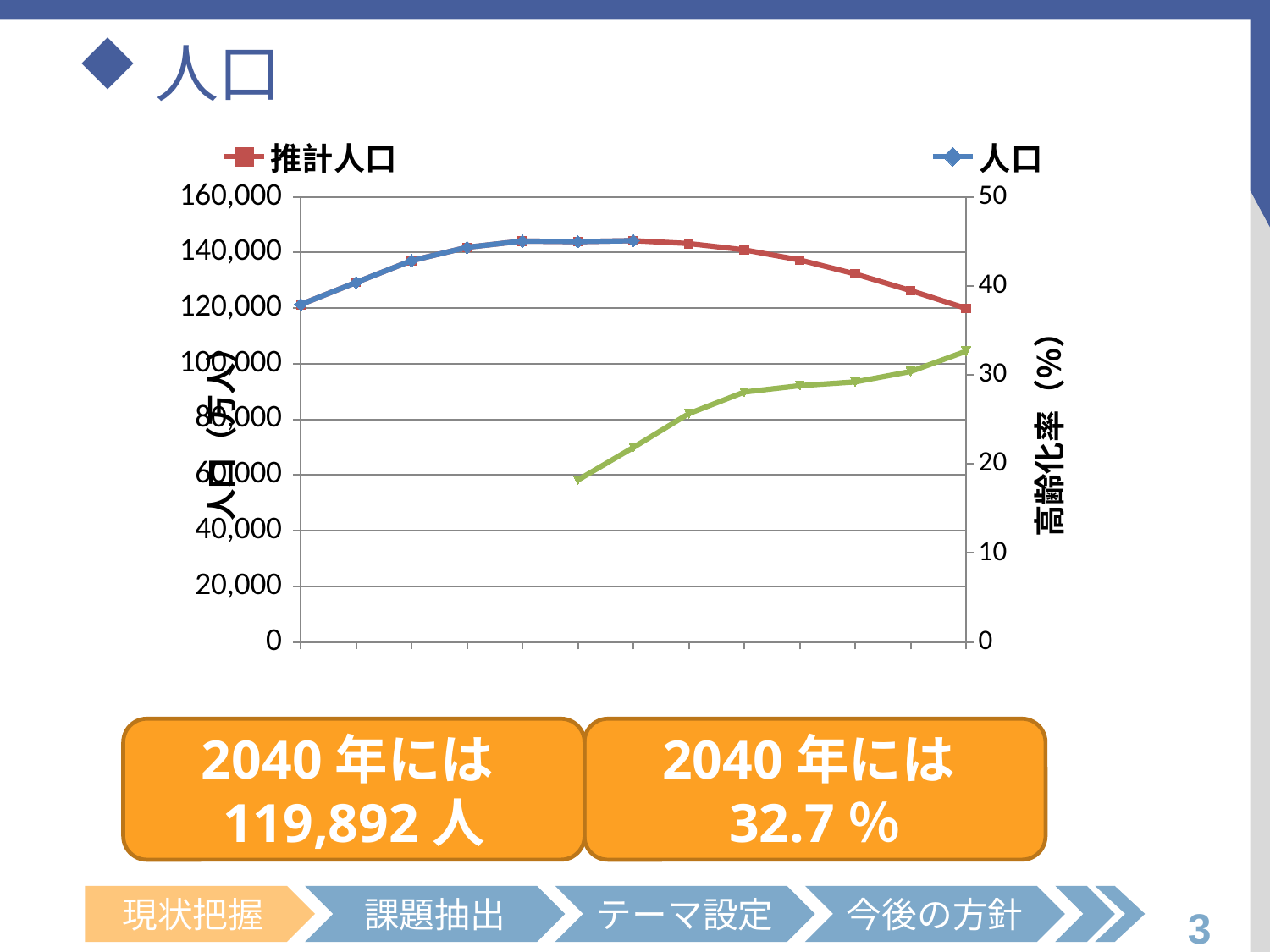
Which is larger: the last point of the 人口 (blue) series or the last point of the 推計人口 (red) series? 人口 Is the highest value of the 人口 (blue) series greater or less than 140,000? greater Is the first point of the green series greater or less than 20 on the right axis? less What are the two series names shown in the chart legend? 推計人口 and 人口 Does the 推計人口 (red) series rise or fall along the x axis? fall According to the slide, what is the projected population (推計人口) in 2040? 119,892 人 Does the green series plotted against the right axis rise or fall along the x axis? rise Is the last point of the green series greater or less than 30 on the right axis? greater What is the title of the right-hand vertical axis of the chart? 高齢化率（%） How many series does the chart legend list? 2 What kind of chart is shown on the slide? line chart